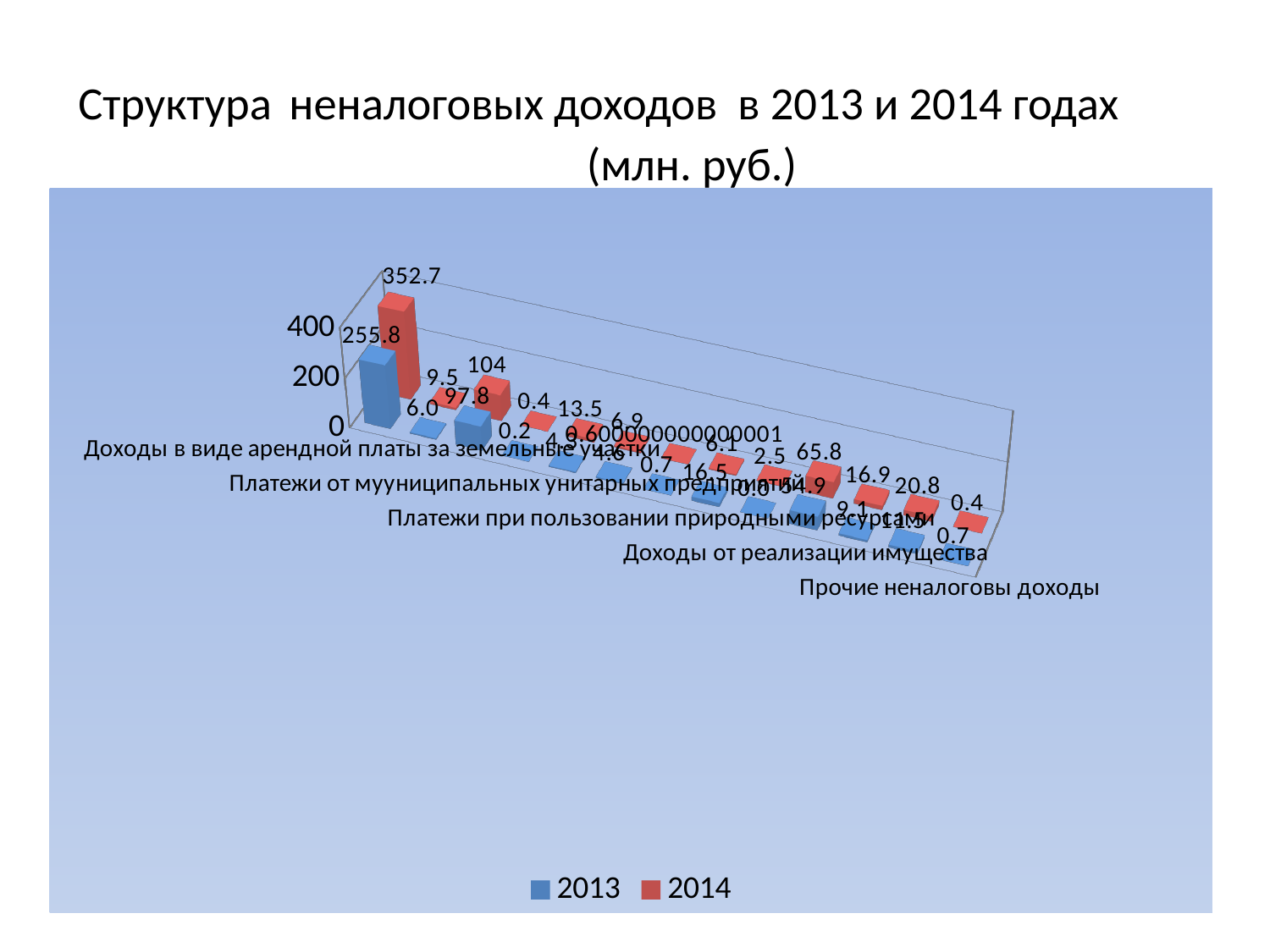
What is the 2014 value for 'Доходы в виде арендной платы за земельные участки'? 352.7 What is the 2013 value for 'Доходы в виде арендной платы за земельные участки'? 255.8 Which category has the highest value in the chart? Доходы в виде арендной платы за земельные участки Which two series are listed in the legend? 2013 and 2014 What is the highest tick value shown on the vertical axis? 400 Is the 2013 value for 'Доходы в виде арендной платы за земельные участки' greater or less than 200? greater What kind of chart is shown on the slide? bar chart What is the difference between the 2014 and 2013 values for 'Доходы в виде арендной платы за земельные участки'? 96.9 How many series does the legend list? 2 For 'Доходы в виде арендной платы за земельные участки', which year has the larger value, 2013 or 2014? 2014